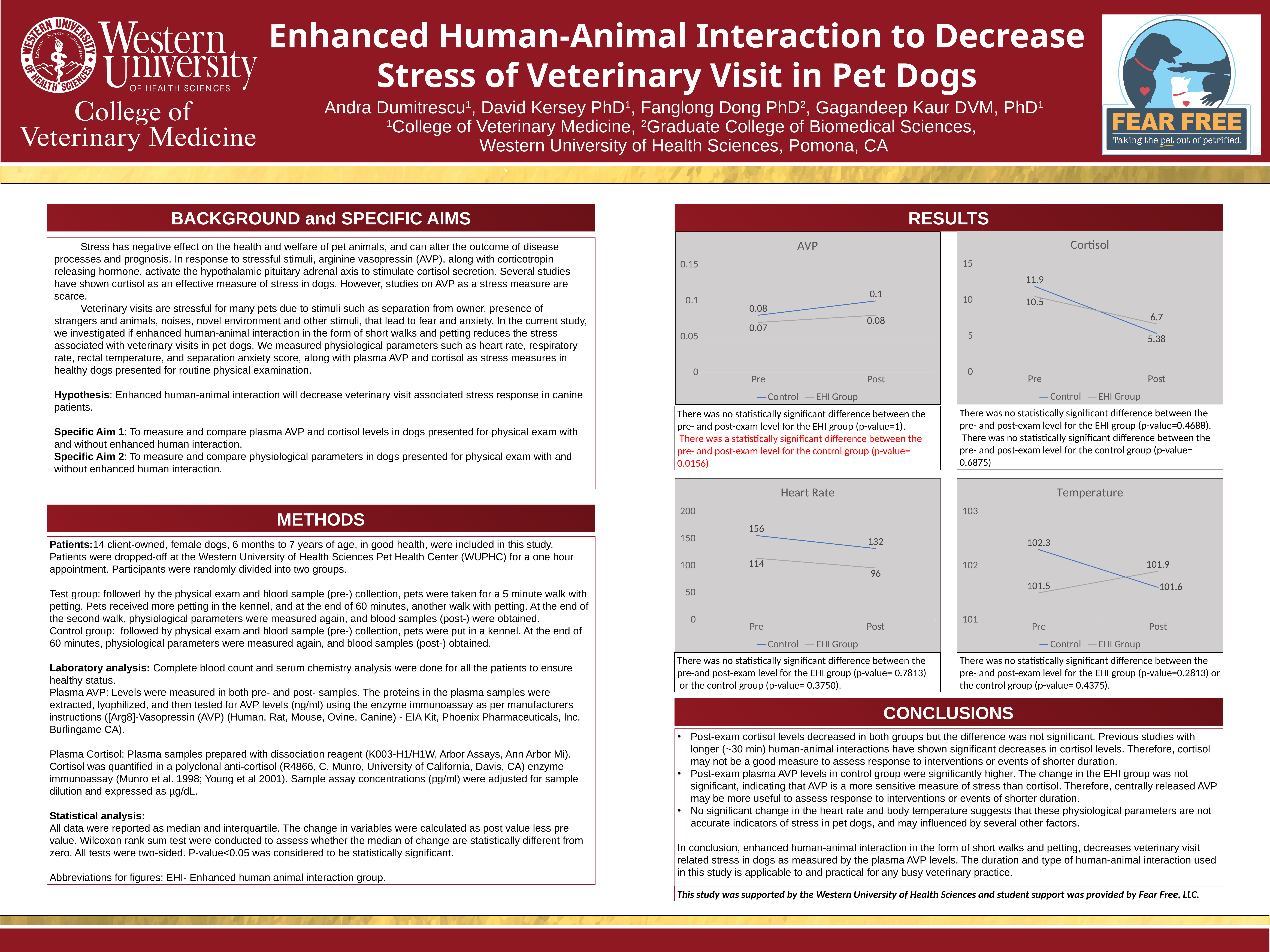
In the Heart Rate chart, what is the Post value for the EHI Group? 96 In the Temperature chart, what is the Pre value for the Control series? 102.3 In the Temperature chart, does the EHI Group series rise or fall from Pre to Post? rise How many series does the legend of the AVP chart list? 2 In the Cortisol chart, does the Control series rise or fall from Pre to Post? fall In the AVP chart, what is the Post value for the Control series? 0.1 What kind of chart is the Cortisol chart? line chart In the Cortisol chart, what is the Pre value for the EHI Group? 10.5 In the Heart Rate chart, what is the difference between the Control Pre and Post values? 24 In the Heart Rate chart, which series has the higher Pre value, Control or EHI Group? Control In the Cortisol chart, what is the Post value for the Control series? 5.38 In the Heart Rate chart, what is the Pre value for the Control series? 156